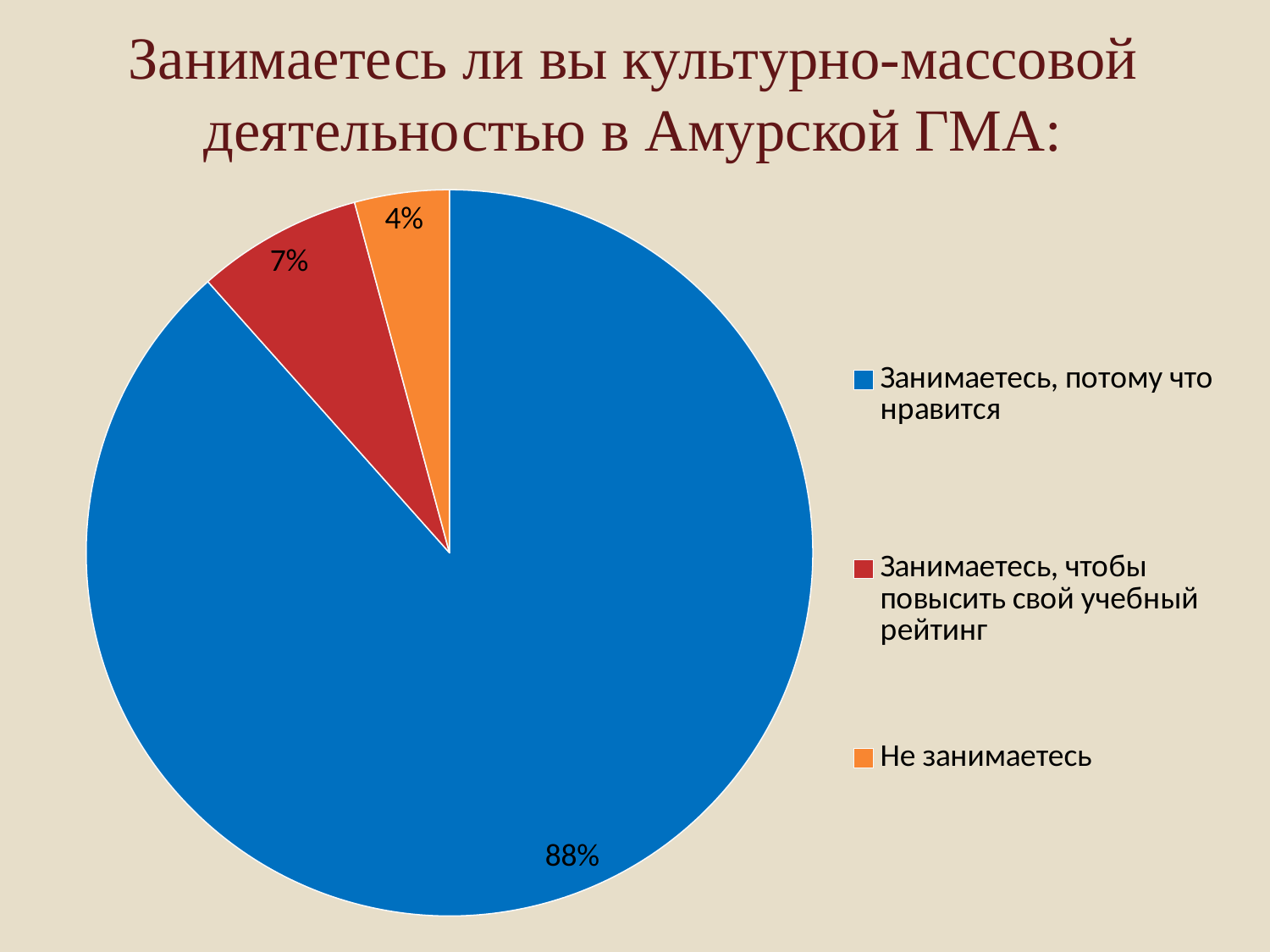
How many categories does the pie chart have? 3 What share of the pie is labelled "Не занимаетесь"? 4% What is the title of the slide? Занимаетесь ли вы культурно-массовой деятельностью в Амурской ГМА: Which category has the largest slice of the pie? Занимаетесь, потому что нравится What is the difference in percentage points between the "Занимаетесь, чтобы повысить свой учебный рейтинг" slice and the "Не занимаетесь" slice? 3 Which is larger: the slice for "Занимаетесь, чтобы повысить свой учебный рейтинг" or the slice for "Не занимаетесь"? Занимаетесь, чтобы повысить свой учебный рейтинг What kind of chart is shown on the slide? Pie chart Which category has the smallest slice of the pie? Не занимаетесь What colour is the slice for "Не занимаетесь"? Orange What is the difference in percentage points between the "Занимаетесь, потому что нравится" slice and the "Не занимаетесь" slice? 84 What share of the pie is labelled "Занимаетесь, чтобы повысить свой учебный рейтинг"? 7% What share of the pie is labelled "Занимаетесь, потому что нравится"? 88%